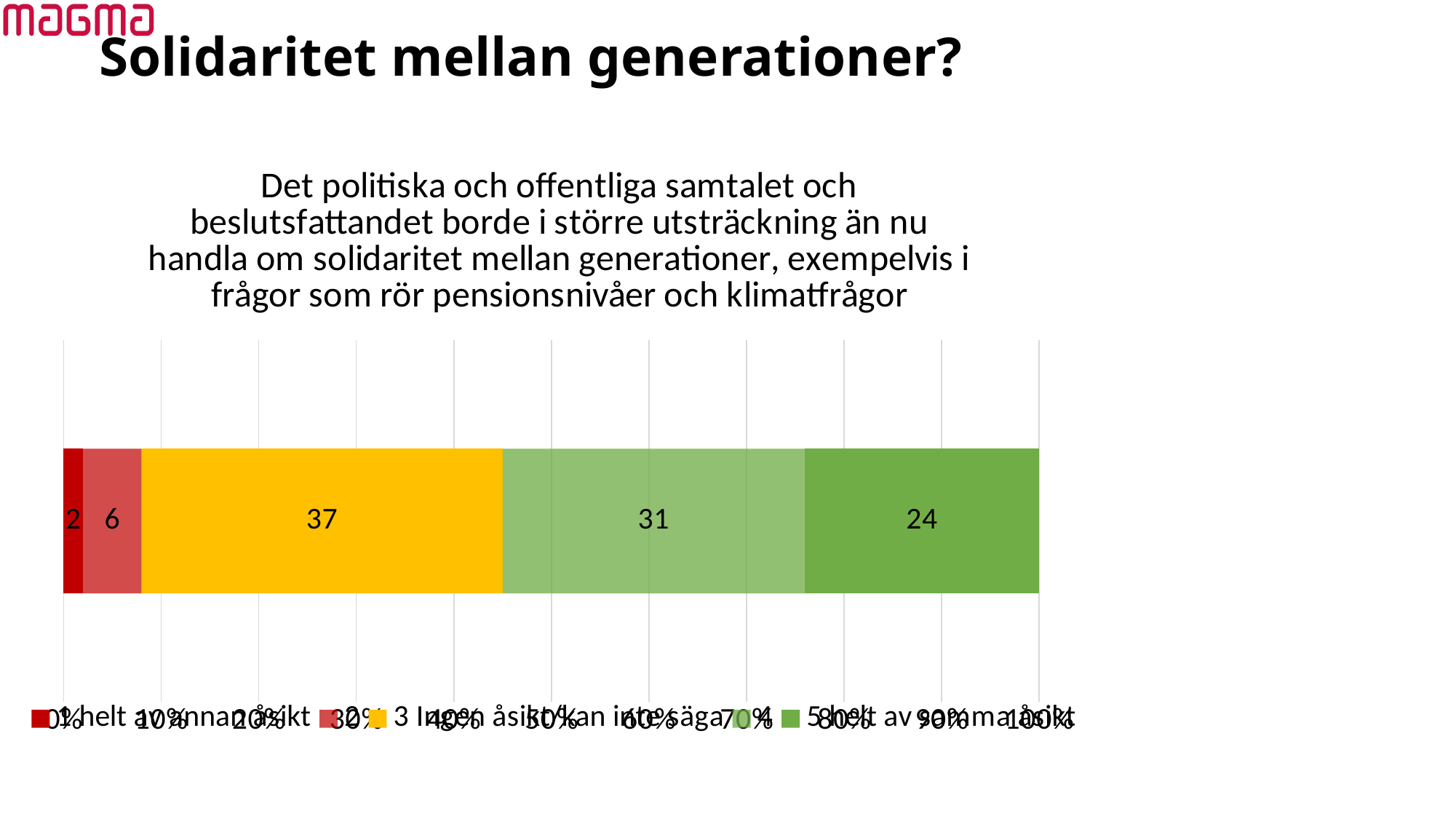
Which segment of the bar has the largest value? the yellow segment (37) What value is printed on the dark green segment at the right end of the bar? 24 Which is larger, the light green segment or the dark green segment? the light green segment (31) What value is printed on the light green segment of the bar? 31 What is the total of all segments in the stacked bar? 100 What kind of chart is shown on the slide? stacked bar chart What value is printed on the lighter red segment, second from the left? 6 How many segments make up the stacked bar? 5 Which segment of the bar has the smallest value? the dark red segment (2) What value is printed on the yellow segment of the bar? 37 What is the difference between the yellow segment (37) and the light green segment (31)? 6 What value is printed on the dark red segment at the left end of the bar? 2